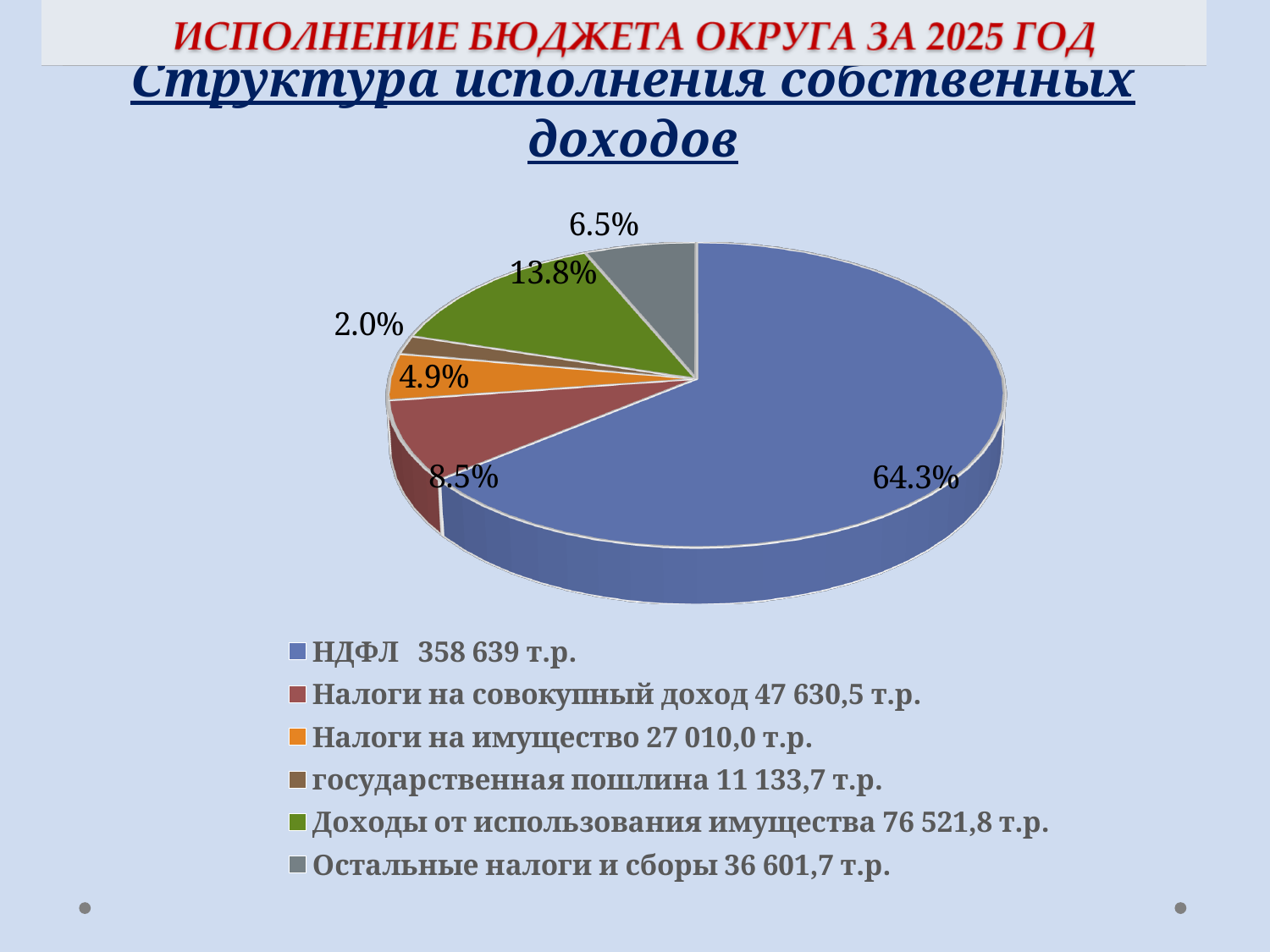
What share of the pie does государственная пошлина account for? 2.0% Which category has the largest slice of the pie? НДФЛ Which is larger: the share for Налоги на имущество or the share for Остальные налоги и сборы? Остальные налоги и сборы What kind of chart is shown on the slide? pie chart What is the difference in percentage points between the НДФЛ share and the Доходы от использования имущества share? 50.5 What share of the pie does Доходы от использования имущества account for? 13.8% Which category has the smallest slice of the pie? государственная пошлина What share of the pie does Налоги на совокупный доход account for? 8.5% How many slices does the pie chart have? 6 What amount in т.р. does the legend give for Налоги на имущество? 27 010,0 т.р.